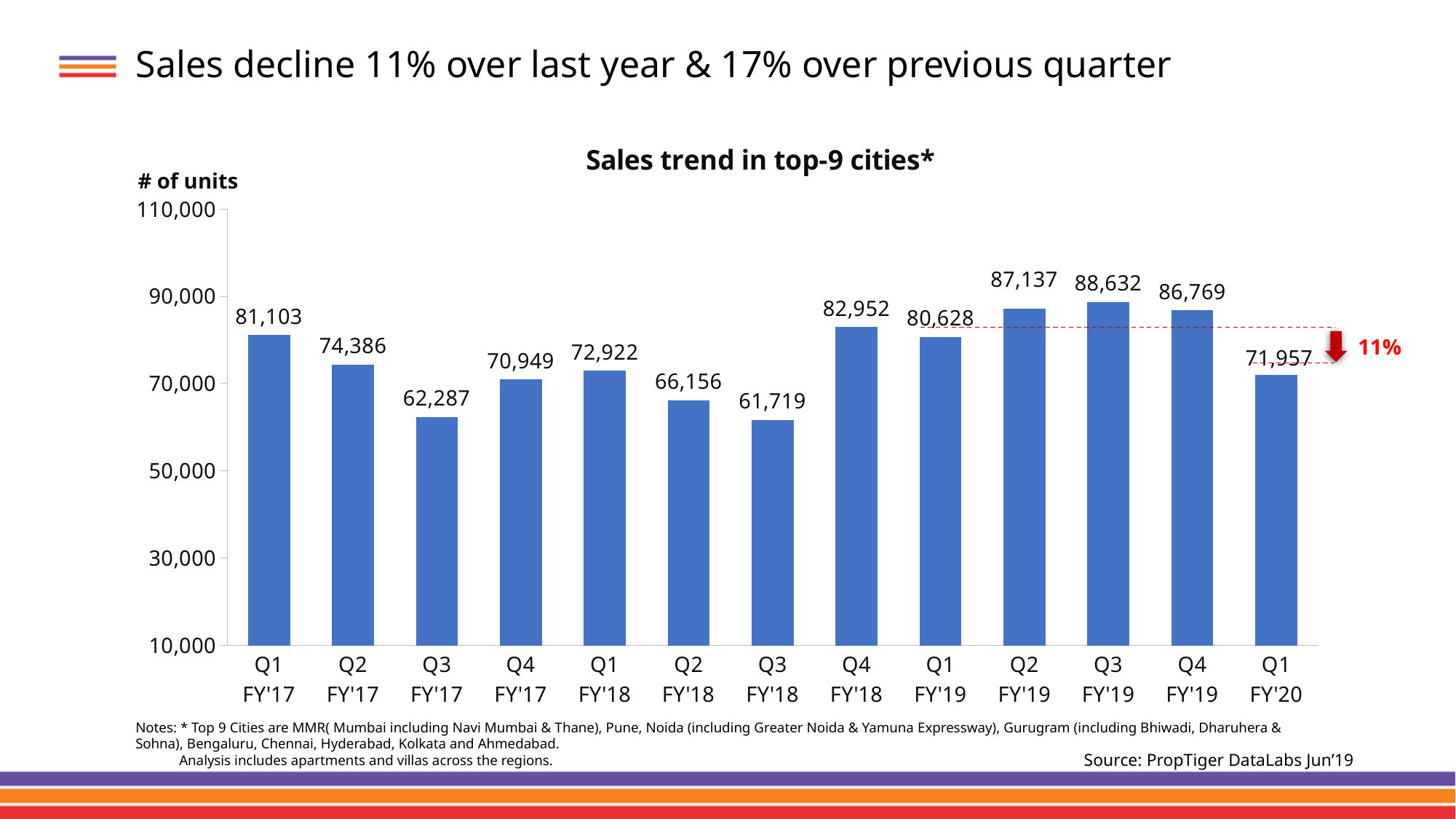
Which quarter has the lowest number of units sold? Q3 FY'18 How many quarters are shown on the chart? 13 What is the difference in units sold between Q1 FY'19 and Q1 FY'20? 8,671 What kind of chart is shown on the slide? Bar chart What is the number of units sold in Q4 FY'18? 82,952 Is the value for Q3 FY'18 greater or less than 70,000? less What is the number of units sold in Q1 FY'20? 71,957 Which quarter had more units sold, Q2 FY'17 or Q2 FY'18? Q2 FY'17 What is the difference in units sold between Q4 FY'19 and Q1 FY'20? 14,812 Which quarter has the highest number of units sold? Q3 FY'19 What is the number of units sold in Q3 FY'17? 62,287 What is the title of the chart? Sales trend in top-9 cities*